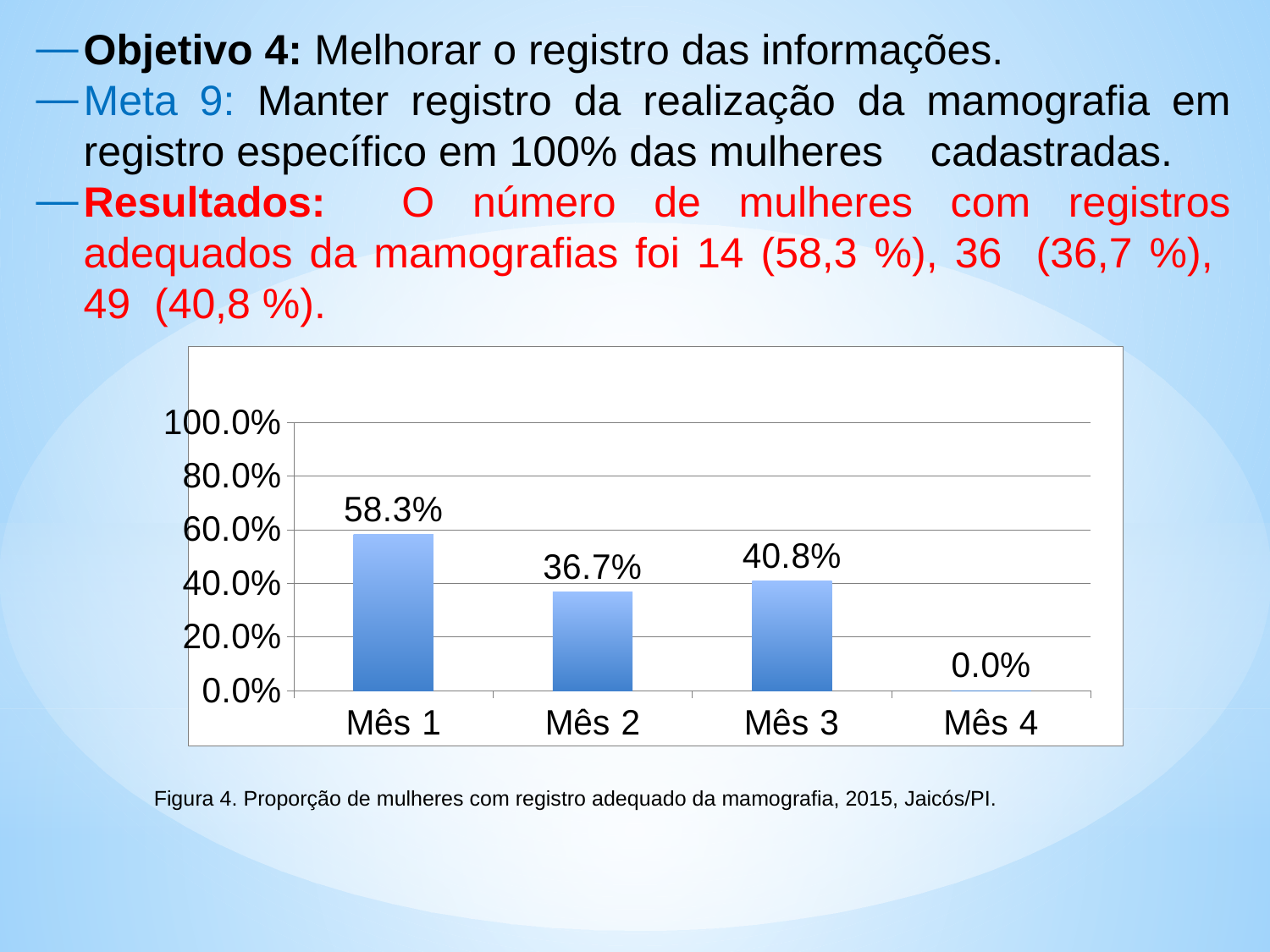
What is the caption of the figure below the chart? Figura 4. Proporção de mulheres com registro adequado da mamografia, 2015, Jaicós/PI. Which month has the highest value? Mês 1 What is the value for Mês 1? 58.3% What is the difference between the values for Mês 1 and Mês 2? 21.6% What kind of chart is shown on the slide? bar chart What is the value for Mês 2? 36.7% What is the value for Mês 3? 40.8% How many categories are shown on the x axis? 4 What is the value for Mês 4? 0.0% Is the value for Mês 1 greater or less than 40.0%? greater Which is larger, the value for Mês 2 or Mês 3? Mês 3 Which month has the lowest value? Mês 4